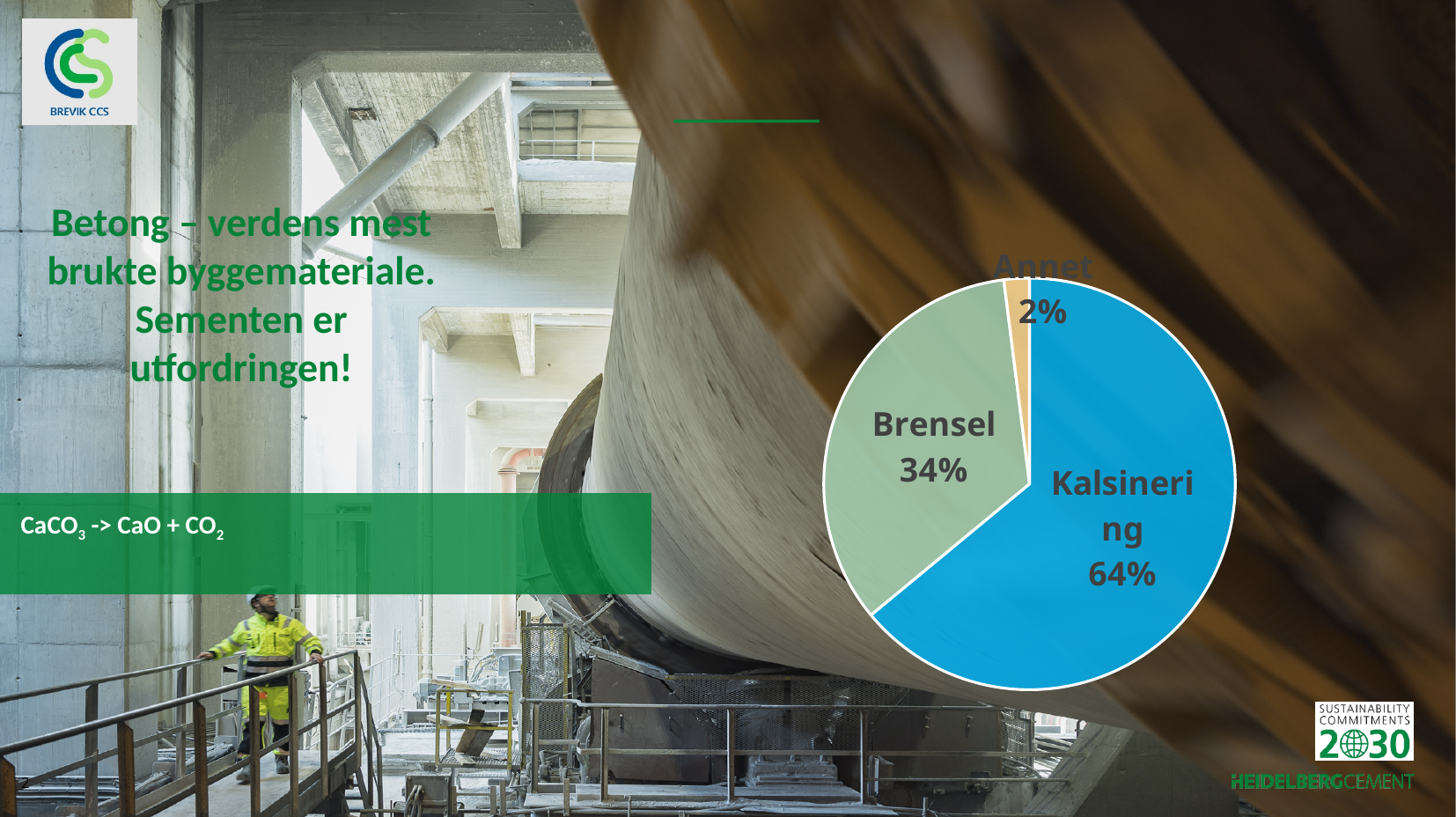
Is the share for Kalsinering greater or less than 50%? greater What share of the pie does Annet have? 2% What is the difference in percentage points between Kalsinering and Brensel? 30 Which slice of the pie chart is the largest? Kalsinering What is the difference in percentage points between Brensel and Annet? 32 Which is larger, the Brensel slice or the Annet slice? Brensel What share of the pie does Kalsinering have? 64% What kind of chart is shown on the slide? pie chart What colour is the Kalsinering slice in the pie chart? blue What share of the pie does Brensel have? 34% How many slices does the pie chart have? 3 Which slice of the pie chart is the smallest? Annet